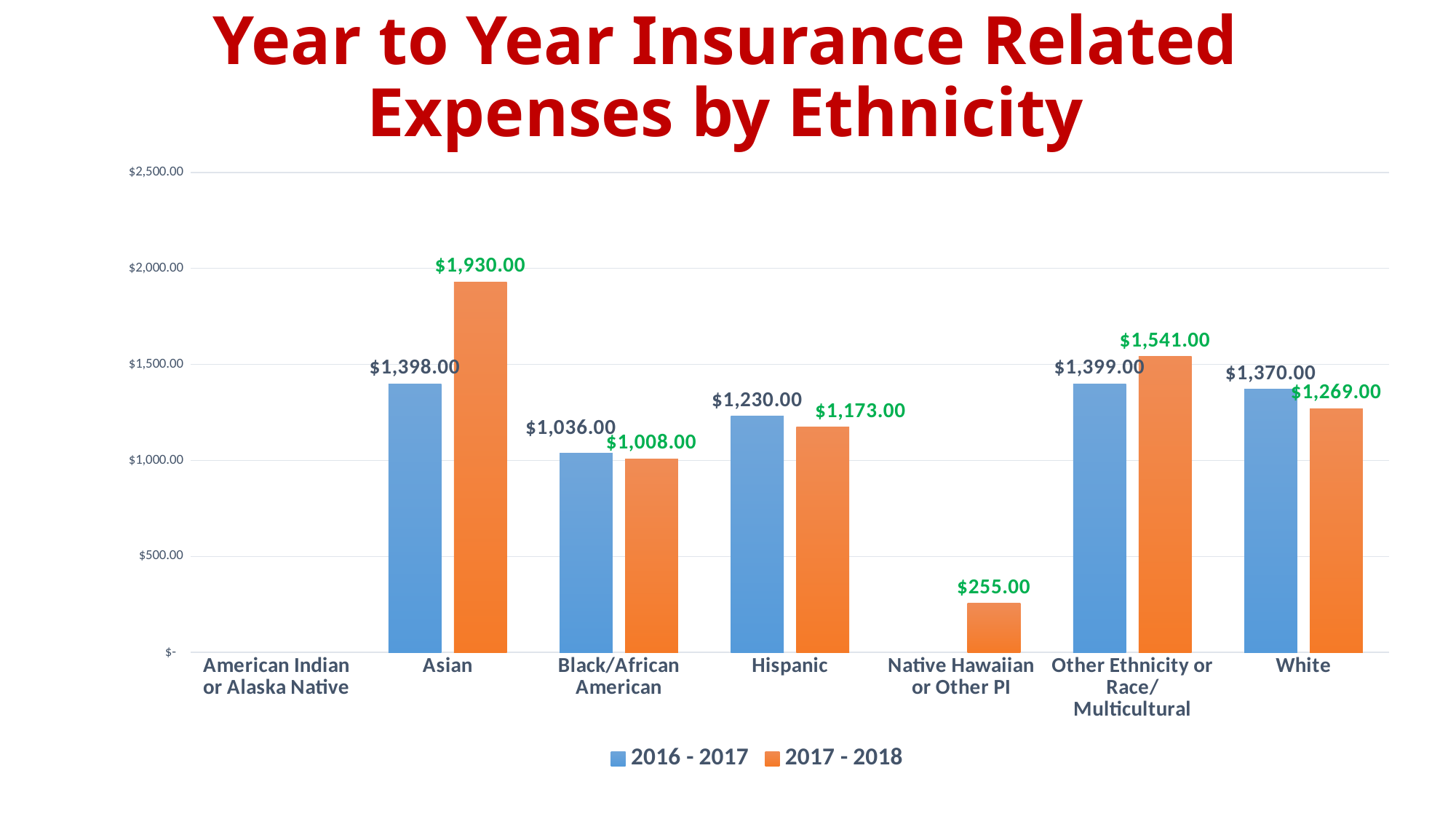
For Hispanic, which series has the larger value, 2016 - 2017 or 2017 - 2018? 2016 - 2017 Which category has the highest 2017 - 2018 value? Asian What is the 2016 - 2017 value for White? $1,370.00 What is the 2017 - 2018 value for Other Ethnicity or Race/Multicultural? $1,541.00 How many series does the legend list? 2 How much higher is the 2017 - 2018 value than the 2016 - 2017 value for Asian? $532.00 What kind of chart is shown on the slide? bar chart What is the difference between the 2016 - 2017 and 2017 - 2018 values for White? $101.00 How many ethnicity categories are shown on the x axis? 7 Is the 2017 - 2018 value for Native Hawaiian or Other PI greater or less than $500.00? less Which category has the lowest 2017 - 2018 value among those with a bar shown? Native Hawaiian or Other PI What is the 2017 - 2018 value for Asian? $1,930.00